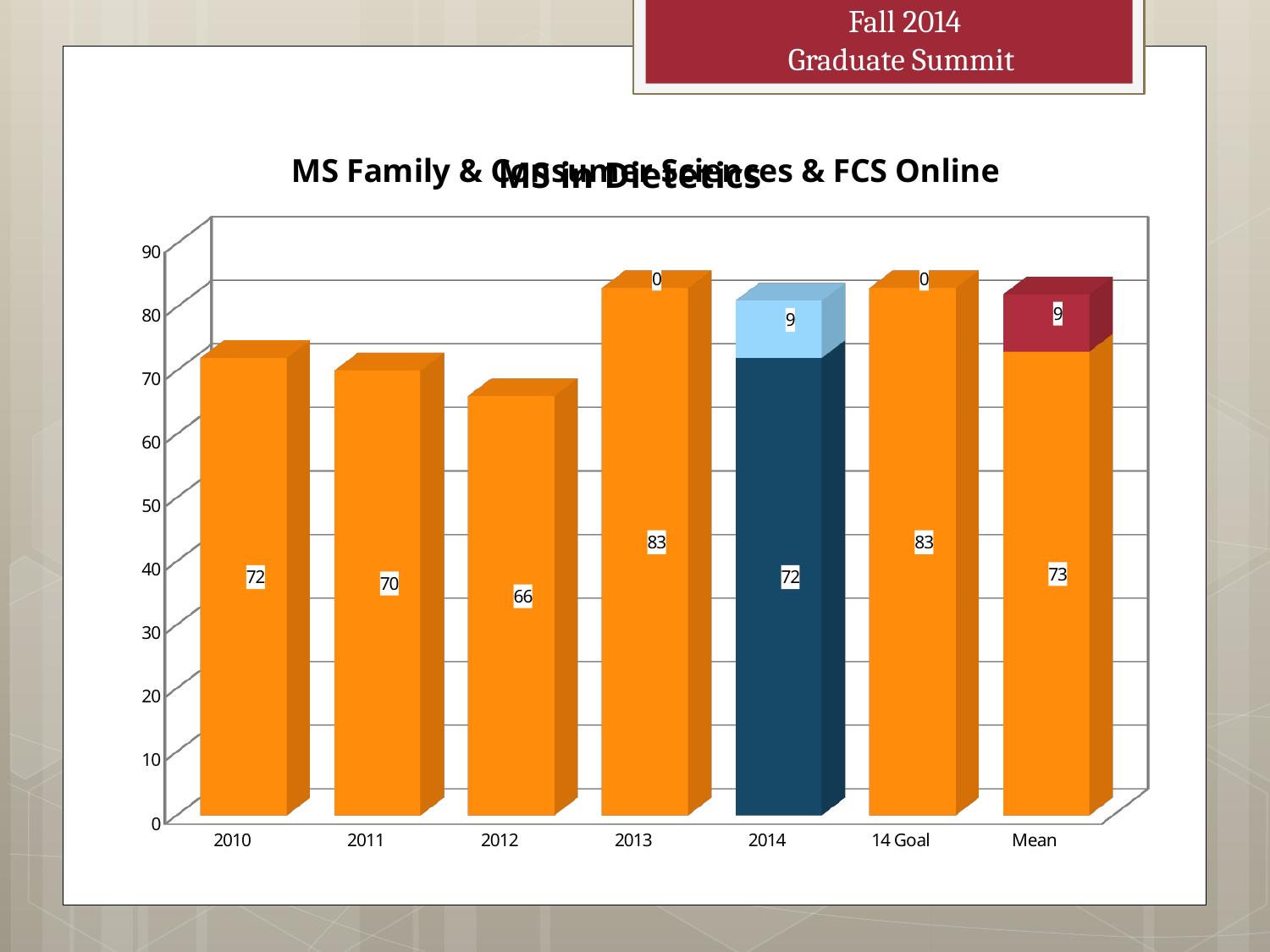
What is the value of the top segment for 2014? 9 What is the value of the bottom segment for 2010? 72 Which year from 2010 to 2013 has the lowest bottom-segment value? 2012 What is the value of the bottom segment for 2012? 66 What kind of chart is shown on the slide? Bar chart How many categories are shown on the x axis? 7 What is the total of the stacked bar for Mean? 82 What is the value of the bottom segment for Mean? 73 Which year from 2010 to 2013 has the highest bottom-segment value? 2013 What is the total of the stacked bar for 2014? 81 What is the value of the bottom segment for 14 Goal? 83 What is the difference between the bottom-segment values for 2013 and 2012? 17